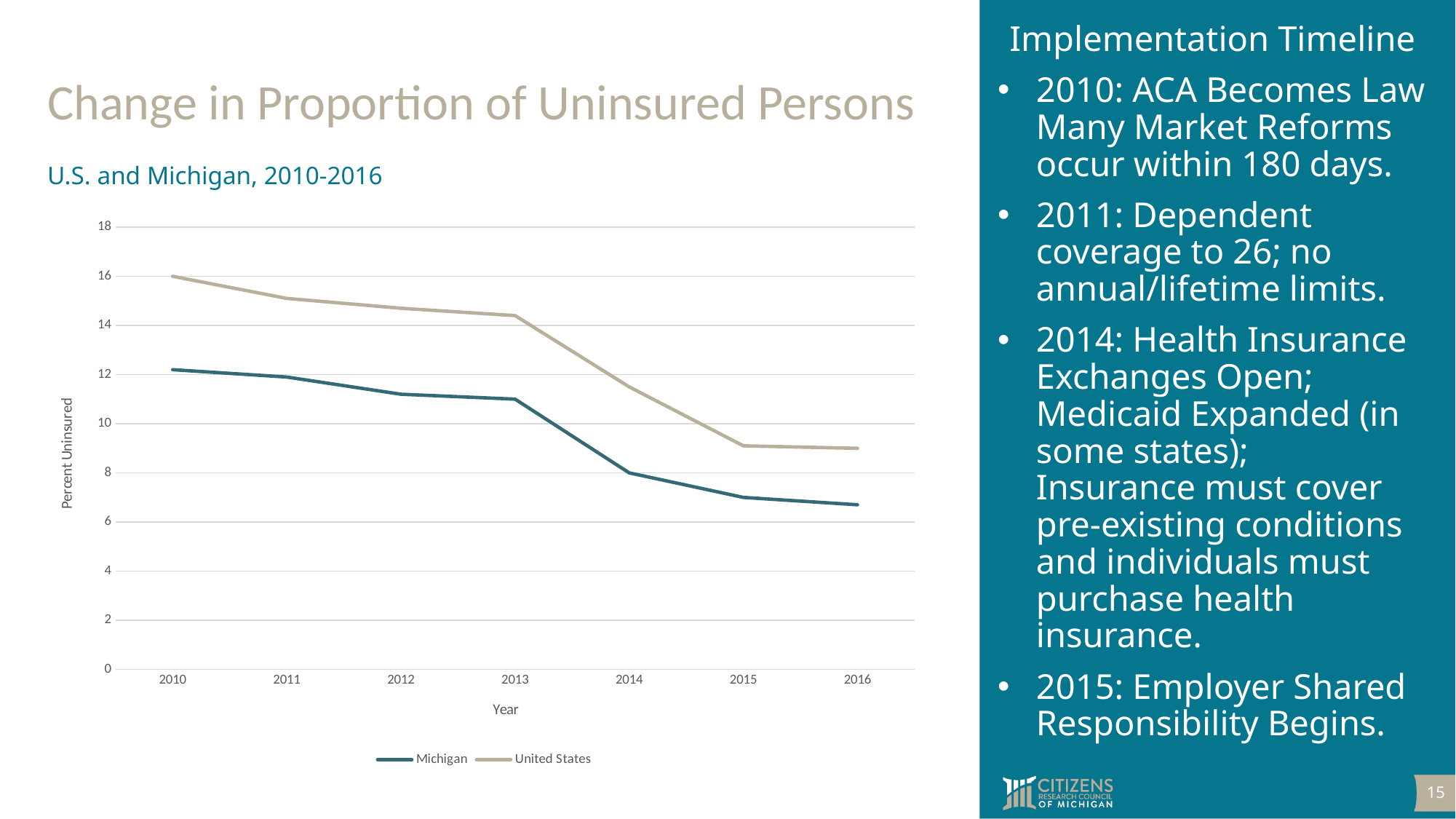
Is the value for the United States in 2013 greater or less than 14? greater In which year is the United States percent uninsured highest? 2010 Does the percent uninsured for the United States rise or fall from 2010 to 2016? fall How many years are plotted along the x axis of the chart? 7 Is the value for Michigan in 2016 greater or less than 8? less Does the percent uninsured for Michigan rise or fall from 2010 to 2016? fall What is the label of the chart's y axis? Percent Uninsured What kind of chart is shown on the slide? line chart In 2013, which series has the higher percent uninsured, Michigan or United States? United States How many series does the chart's legend list? 2 In which year is the Michigan percent uninsured lowest? 2016